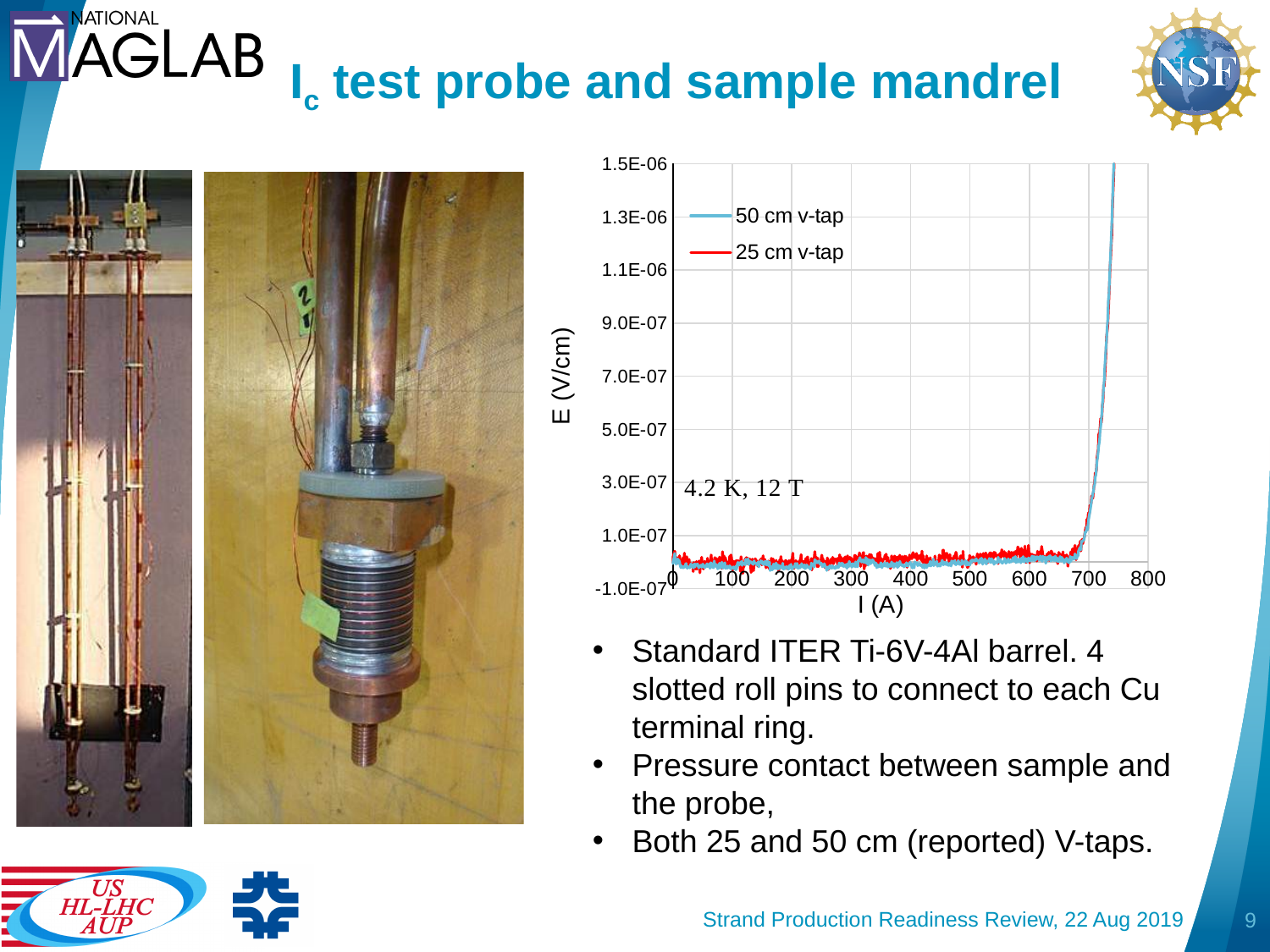
What is the highest value shown on the x axis of the chart? 800 What is the label of the x axis of the chart? I (A) Is the value of the 50 cm v-tap series at 500 A greater or less than 3.0E-07? less Is the value of the 25 cm v-tap series at 300 A greater or less than 1.0E-07? less What kind of chart is shown on the slide? line chart What are the two series named in the chart legend? 50 cm v-tap and 25 cm v-tap How does E (V/cm) change as I (A) increases beyond about 700 A? rises sharply How many series does the chart legend list? 2 How does E (V/cm) behave as I (A) increases from 0 to about 650 A? stays roughly flat near zero